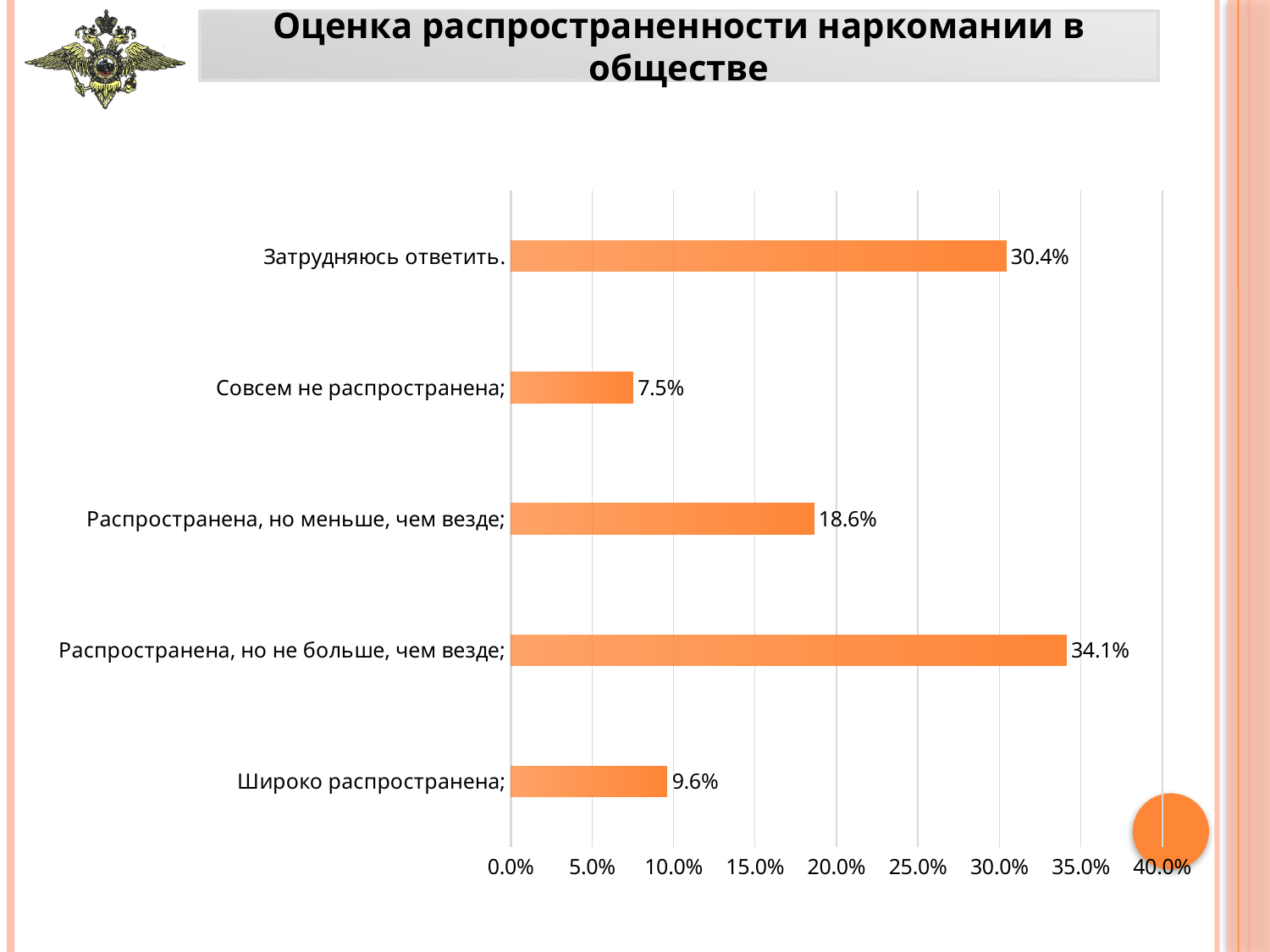
Which category has the highest value? Распространена, но не больше, чем везде Is the value for "Распространена, но меньше, чем везде" greater or less than 20.0%? less Which category has the lowest value? Совсем не распространена What is the value for "Затрудняюсь ответить"? 30.4% What is the value for "Распространена, но меньше, чем везде"? 18.6% What is the title of the slide? Оценка распространенности наркомании в обществе What is the difference between "Распространена, но не больше, чем везде" and "Затрудняюсь ответить"? 3.7% Which is larger: "Широко распространена" or "Совсем не распространена"? Широко распространена How many categories are shown in the chart? 5 What is the value for "Совсем не распространена"? 7.5% What kind of chart is shown on the slide? bar chart What is the value for "Широко распространена"? 9.6%